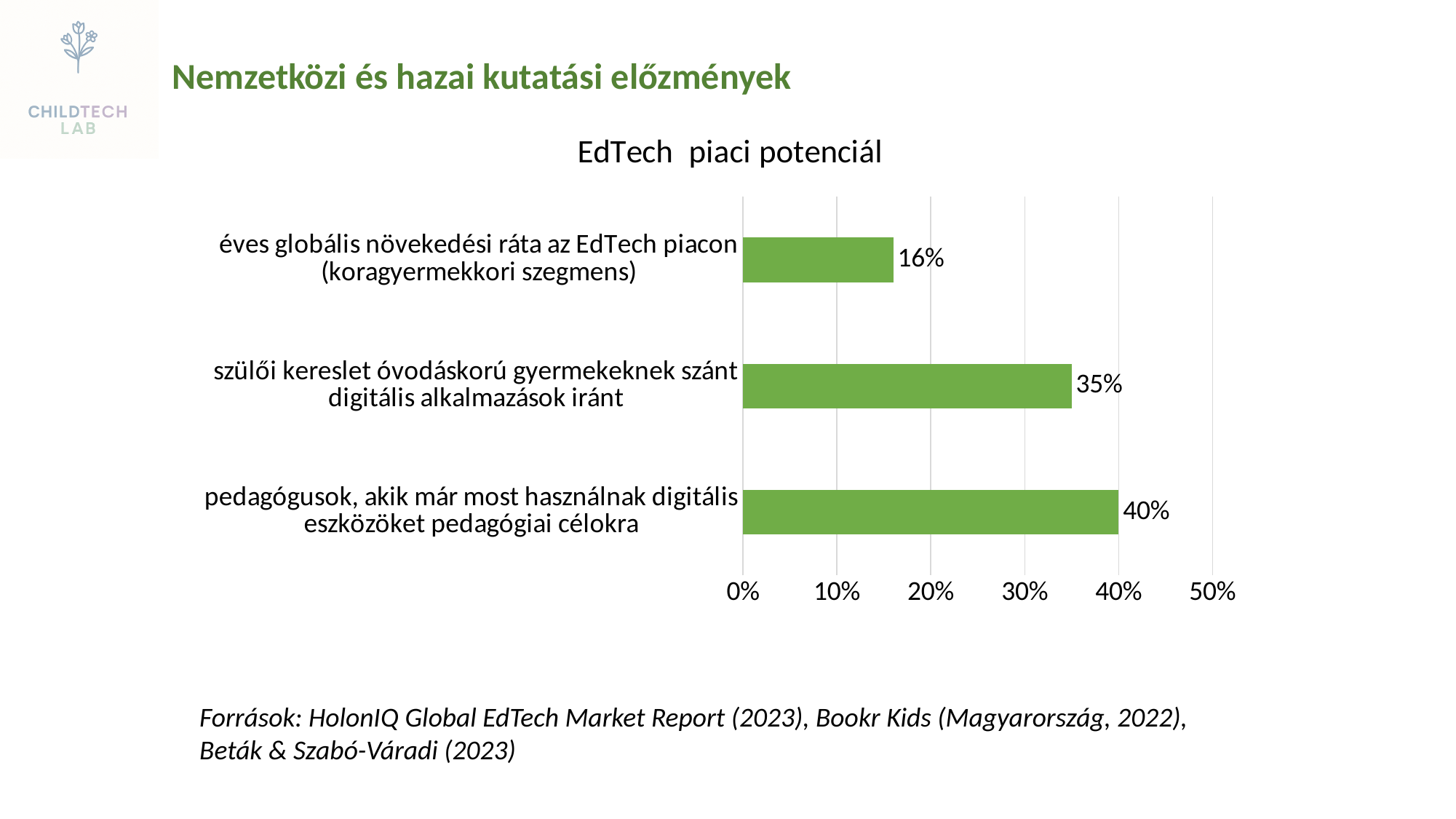
What is the value for 'pedagógusok, akik már most használnak digitális eszközöket pedagógiai célokra'? 40% Which category has the highest value? pedagógusok, akik már most használnak digitális eszközöket pedagógiai célokra What is the value for 'éves globális növekedési ráta az EdTech piacon (koragyermekkori szegmens)'? 16% What is the title of the chart? EdTech piaci potenciál What is the difference between the value for 'pedagógusok, akik már most használnak digitális eszközöket pedagógiai célokra' and the value for 'szülői kereslet óvodáskorú gyermekeknek szánt digitális alkalmazások iránt'? 5% Which category has the lowest value? éves globális növekedési ráta az EdTech piacon (koragyermekkori szegmens) What is the value for 'szülői kereslet óvodáskorú gyermekeknek szánt digitális alkalmazások iránt'? 35% Which is larger: the value for 'szülői kereslet óvodáskorú gyermekeknek szánt digitális alkalmazások iránt' or the value for 'éves globális növekedési ráta az EdTech piacon (koragyermekkori szegmens)'? szülői kereslet óvodáskorú gyermekeknek szánt digitális alkalmazások iránt What kind of chart is shown on the slide? bar chart How many categories are shown in the chart? 3 Is the value for 'szülői kereslet óvodáskorú gyermekeknek szánt digitális alkalmazások iránt' greater or less than 30%? greater What is the difference between the value for 'pedagógusok, akik már most használnak digitális eszközöket pedagógiai célokra' and the value for 'éves globális növekedési ráta az EdTech piacon (koragyermekkori szegmens)'? 24%